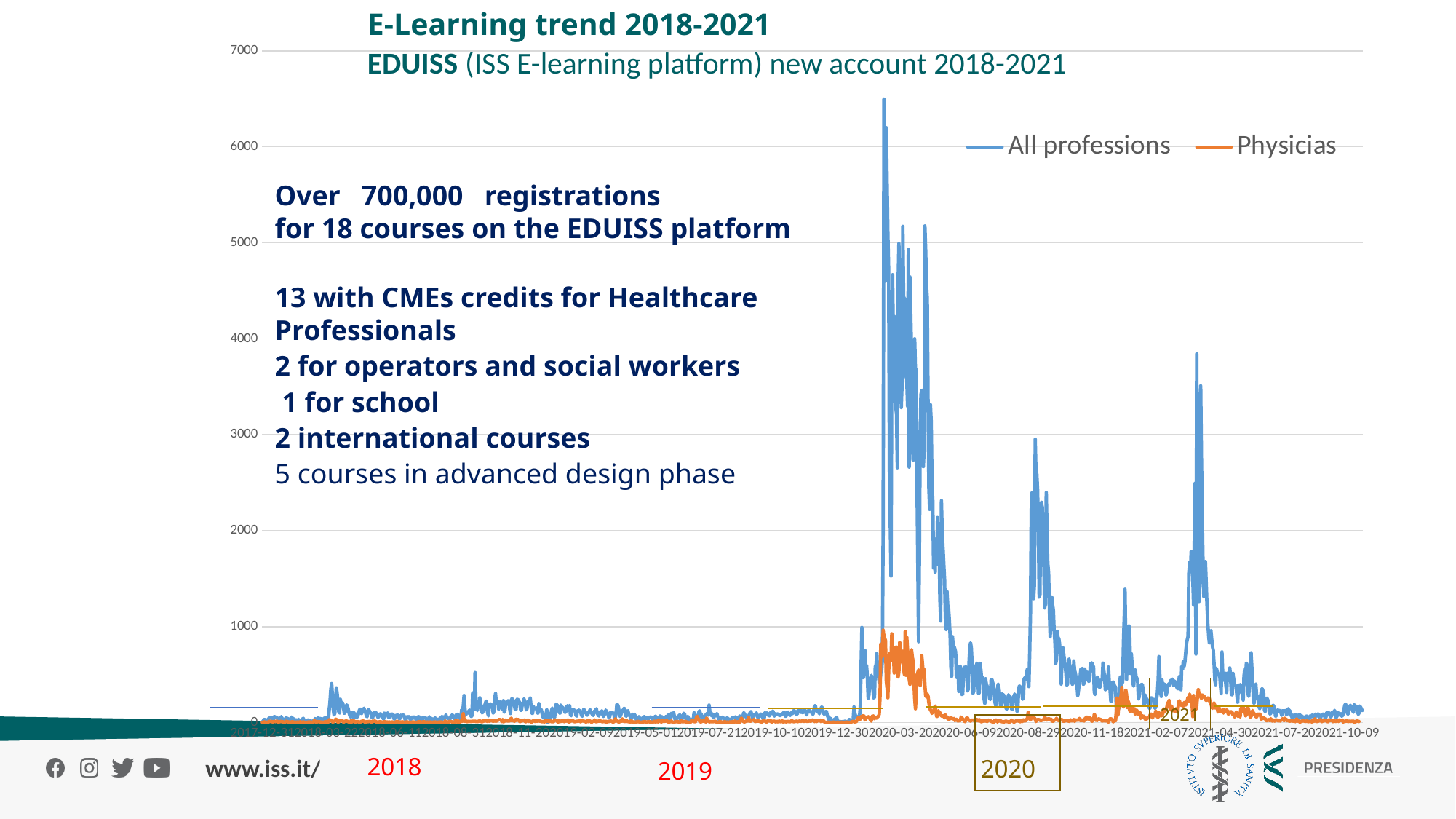
How many series does the chart legend list? 2 Is the peak of the 'All professions' series in early 2021 greater or less than 3000? greater What kind of chart is shown on the slide? Line chart Is the highest peak of the 'Physicias' series greater or less than 2000? less Which colour is used for the 'All professions' series? Blue Is the highest peak of the 'All professions' series greater or less than 6000? greater What are the two series named in the chart legend? All professions and Physicias Which series reaches the higher peak, 'All professions' or 'Physicias'? All professions In which year does the 'All professions' series reach its highest peak? 2020 What is the highest value shown on the chart's vertical axis? 7000